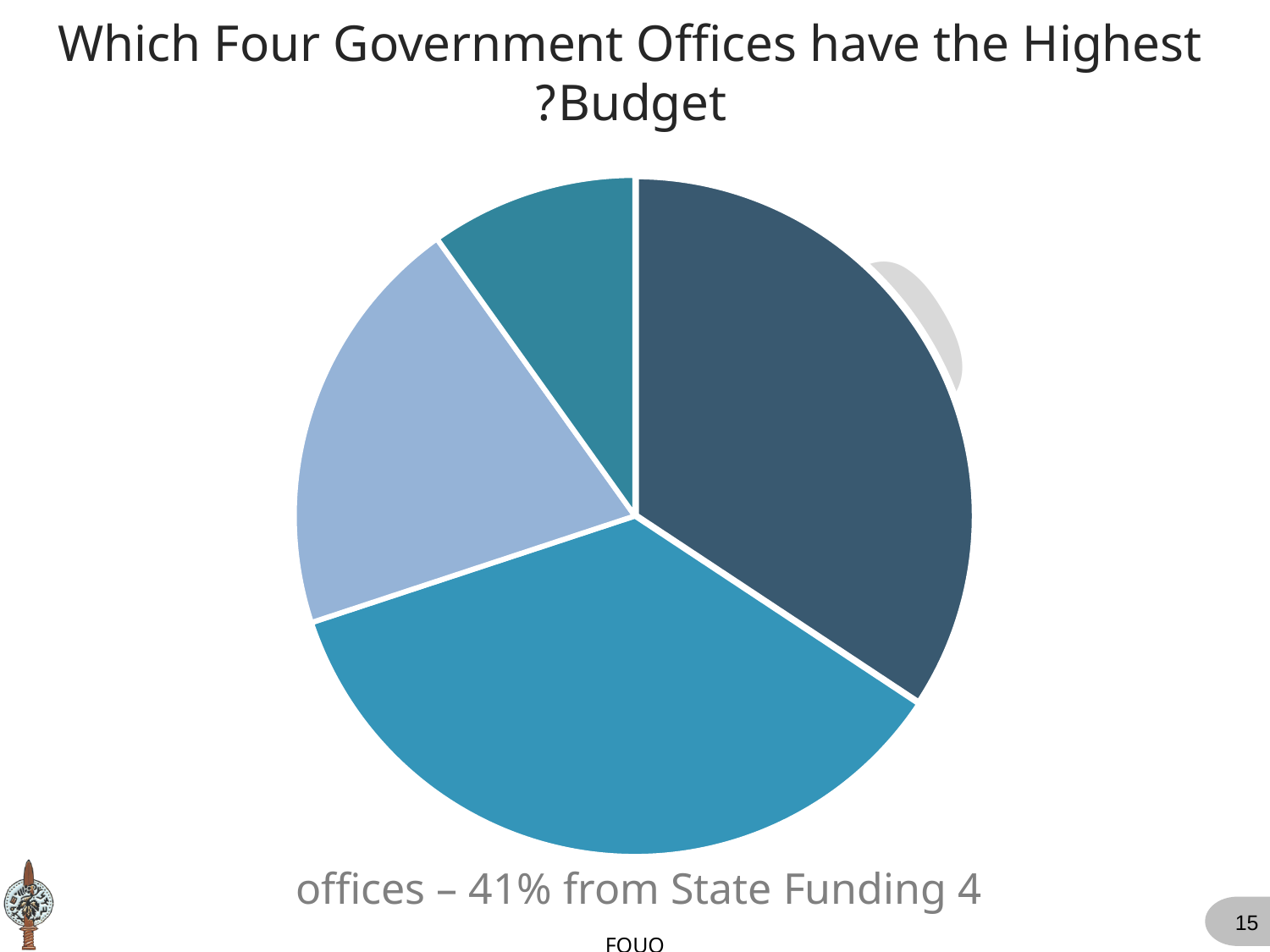
Which colour slice of the pie chart is the smallest? the teal slice at the top Which is larger in the pie chart, the light blue slice on the left or the teal slice at the top? the light blue slice According to the caption below the pie chart, what percentage of State Funding do the 4 offices account for? 41% What is the title of the slide containing the pie chart? Which Four Government Offices have the Highest Budget? How many slices does the pie chart have? 4 What kind of chart is shown on the slide? pie chart